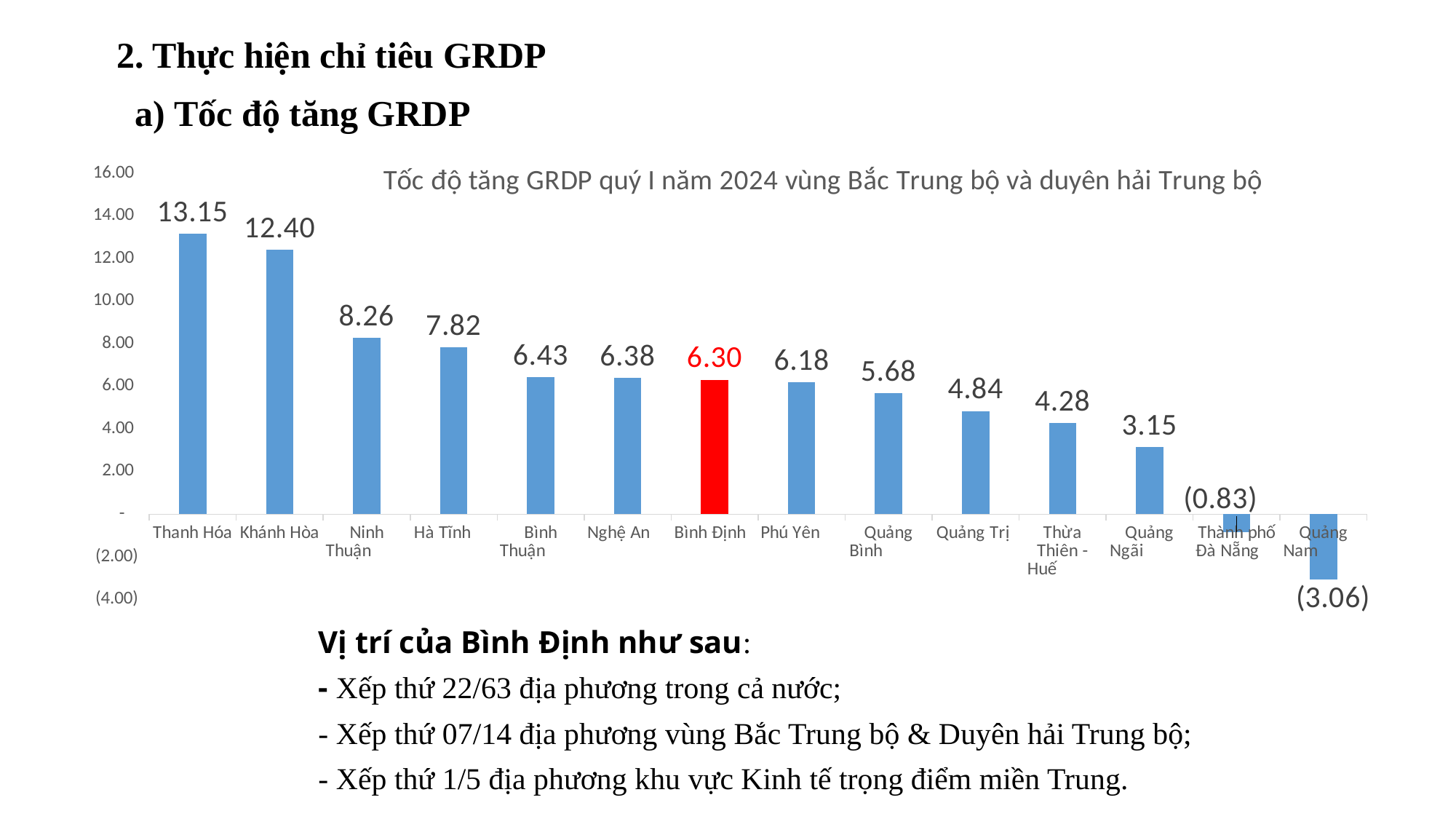
How many provinces are shown in the chart? 14 What value is shown for Thanh Hóa? 13.15 What kind of chart is shown on the slide? Bar chart Which has a higher value, Quảng Trị or Thừa Thiên - Huế? Quảng Trị Which province has the highest GRDP growth rate in the chart? Thanh Hóa Which province has the lowest GRDP growth rate in the chart? Quảng Nam What is the difference between the values for Thanh Hóa and Khánh Hòa? 0.75 Which bar in the chart is coloured red? Bình Định What is the GRDP growth rate shown for Bình Định? 6.30 What value is shown for Quảng Nam? (3.06) What is the difference between the values for Ninh Thuận and Hà Tĩnh? 0.44 What value is shown for Thành phố Đà Nẵng? (0.83)